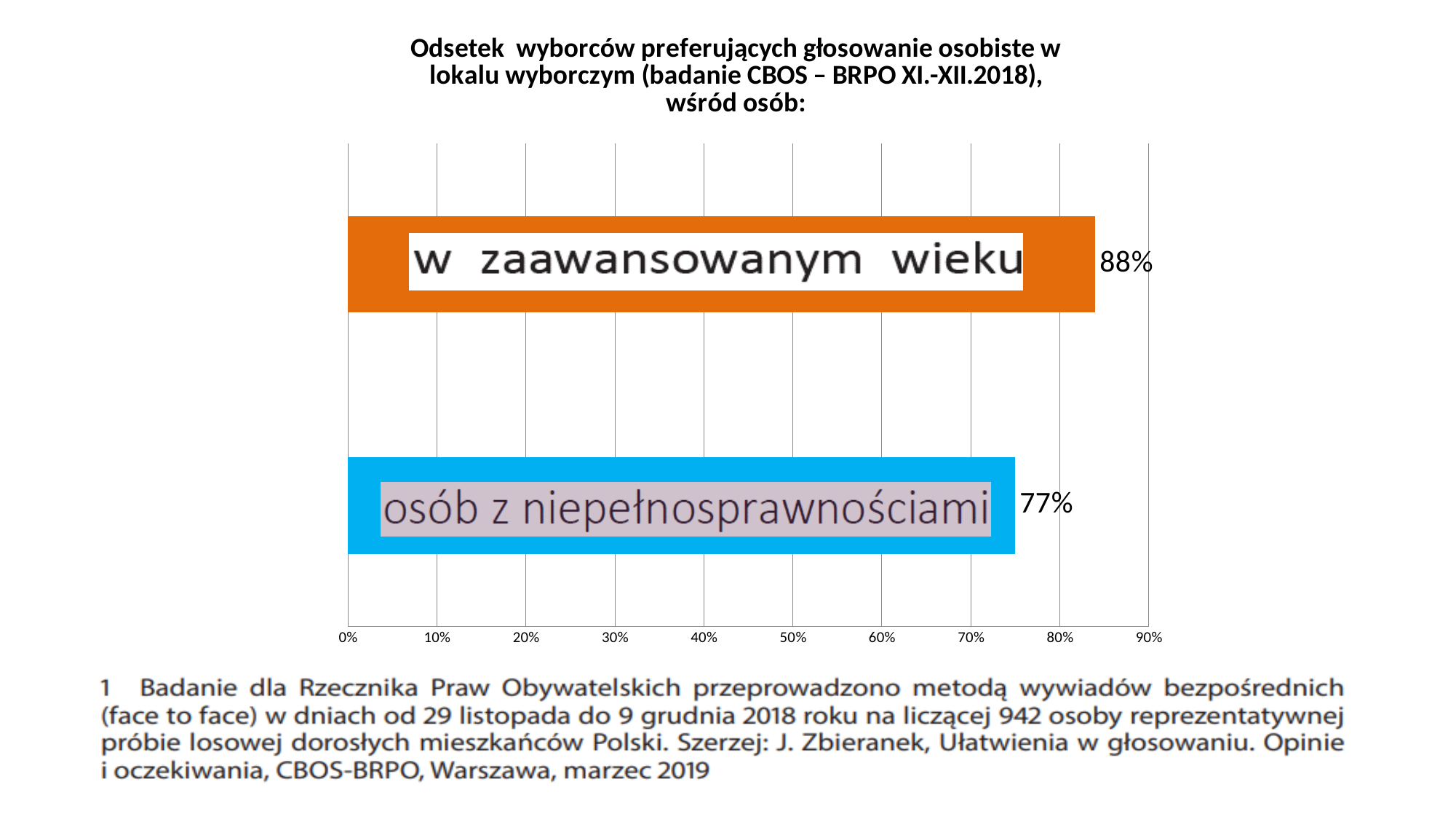
Is the value for "osób z niepełnosprawnościami" greater or less than 50%? greater Which is larger: the value for "w zaawansowanym wieku" or for "osób z niepełnosprawnościami"? w zaawansowanym wieku What is the maximum value shown on the horizontal axis? 90% What is the value for "osób z niepełnosprawnościami"? 77% Which category has the highest value? w zaawansowanym wieku Which category has the lowest value? osób z niepełnosprawnościami What is the difference between the values for "w zaawansowanym wieku" and "osób z niepełnosprawnościami"? 11% What kind of chart is shown on the slide? bar chart What colour is the bar for "osób z niepełnosprawnościami"? blue What is the value for "w zaawansowanym wieku"? 88% How many categories are shown in the chart? 2